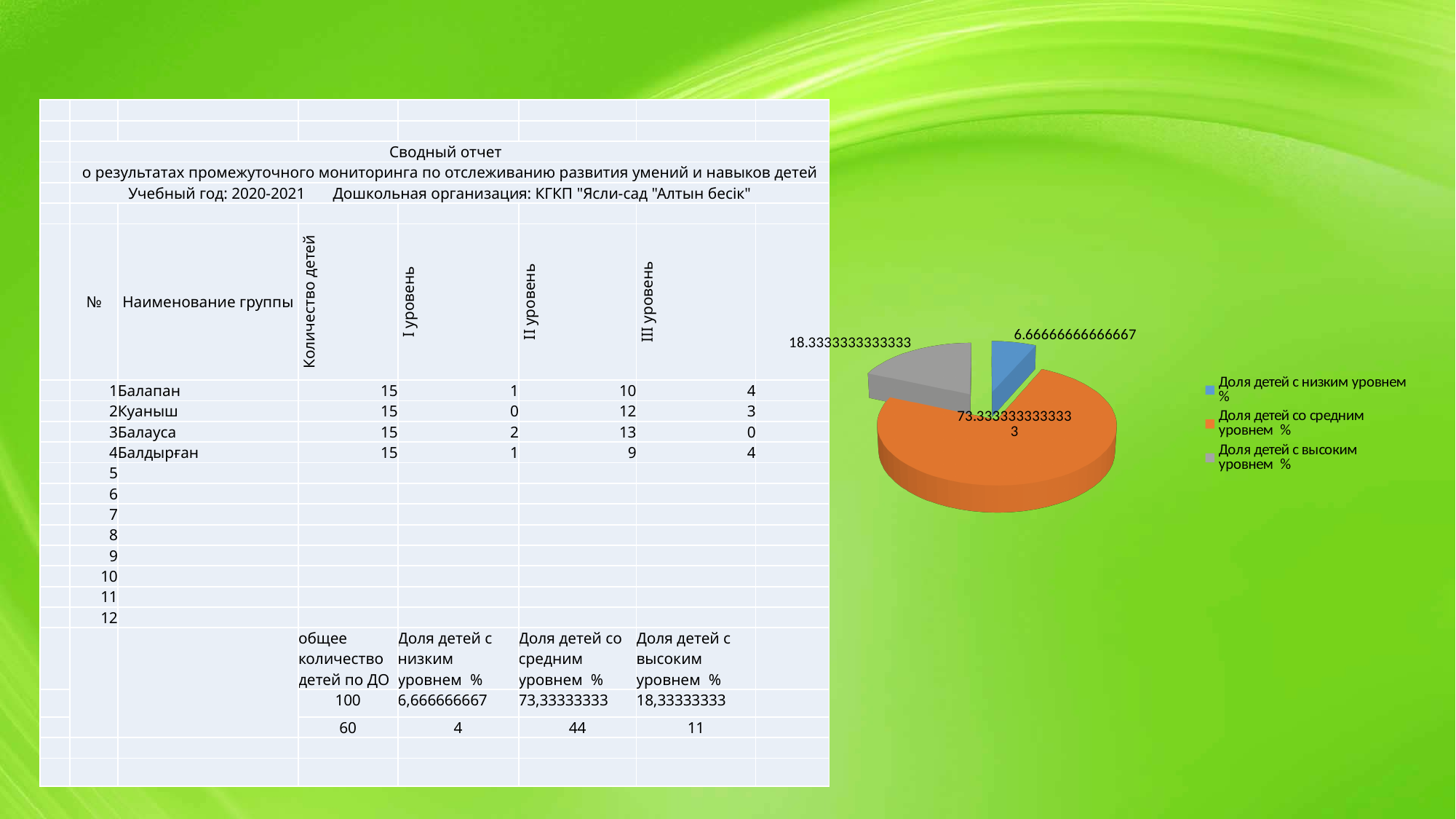
What value is labelled on the pie slice for "Доля детей со средним уровнем %"? 73.3333333333333 What colour is the slice for "Доля детей со средним уровнем %" in the pie chart? orange What value is labelled on the pie slice for "Доля детей с высоким уровнем %"? 18.3333333333333 Which legend category has the largest slice in the pie chart? Доля детей со средним уровнем % What kind of chart is shown on the right side of the slide? pie chart How many entries does the pie chart's legend list? 3 What colour is the slice for "Доля детей с высоким уровнем %" in the pie chart? gray Which legend category has the smallest slice in the pie chart? Доля детей с низким уровнем % What value is labelled on the pie slice for "Доля детей с низким уровнем %"? 6.66666666666667 In the pie chart, which slice is larger: "Доля детей с высоким уровнем %" or "Доля детей с низким уровнем %"? Доля детей с высоким уровнем % How many slices does the pie chart have? 3